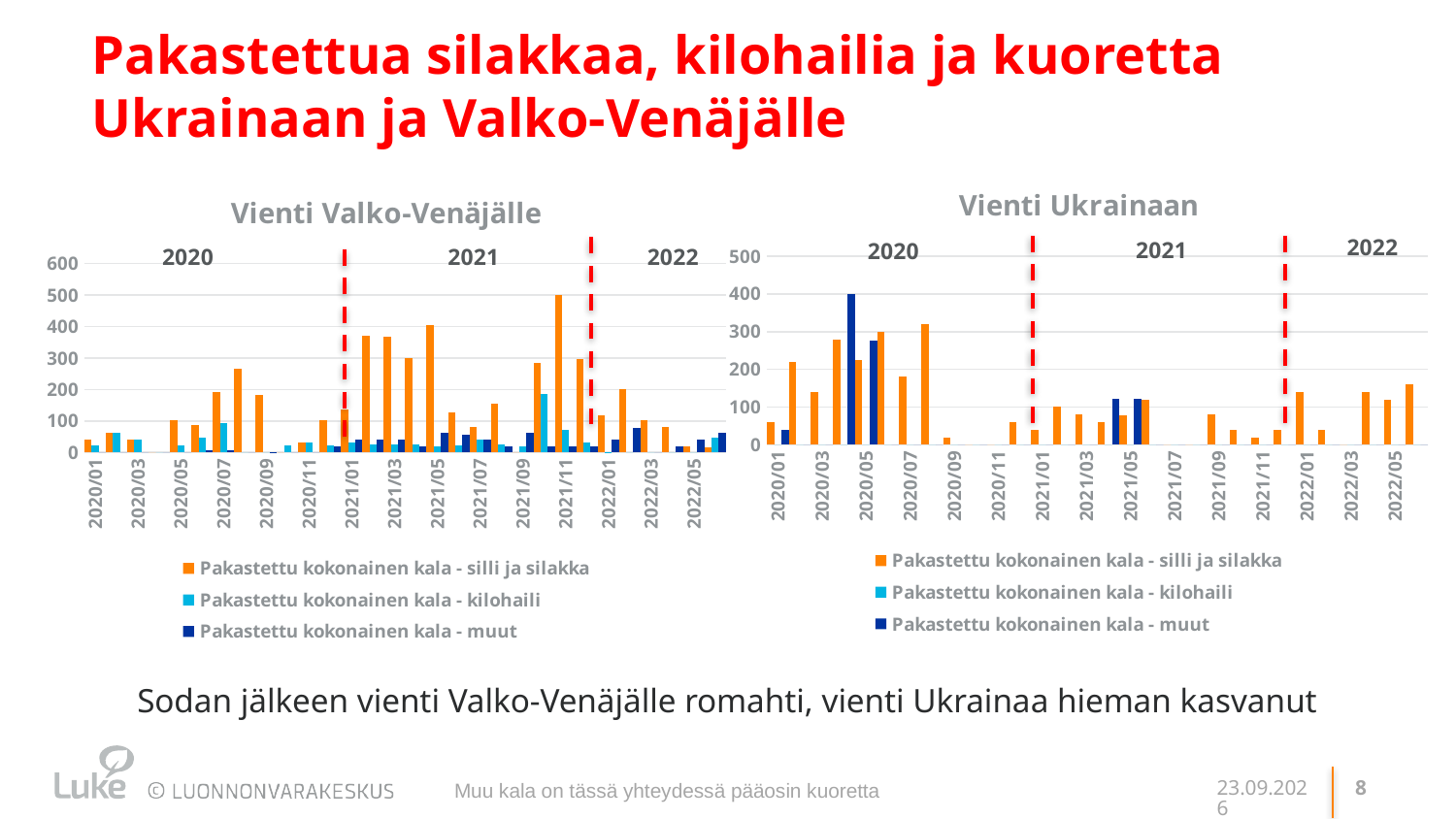
In the "Vienti Valko-Venäjälle" chart, which is larger: the "Pakastettu kokonainen kala - silli ja silakka" bar for 2021/11 or for 2020/01? 2021/11 In the "Vienti Valko-Venäjälle" chart, do the "Pakastettu kokonainen kala - silli ja silakka" values generally rise or fall from 2022/01 to 2022/05? fall Which series in the "Vienti Valko-Venäjälle" chart is shown in orange? Pakastettu kokonainen kala - silli ja silakka In the "Vienti Valko-Venäjälle" chart, which month has the highest "Pakastettu kokonainen kala - silli ja silakka" bar? 2021/11 How many series does the legend of the "Vienti Ukrainaan" chart list? 3 In the "Vienti Ukrainaan" chart, is the value of the "Pakastettu kokonainen kala - muut" bar for 2020/04 greater or less than 300? greater In the "Vienti Valko-Venäjälle" chart, is the value of the "Pakastettu kokonainen kala - silli ja silakka" bar for 2021/11 greater or less than 400? greater What is the highest value shown on the y axis of the "Vienti Ukrainaan" chart? 500 In the "Vienti Ukrainaan" chart, is the value of the "Pakastettu kokonainen kala - silli ja silakka" bar for 2022/05 greater or less than 100? greater What kind of chart is "Vienti Valko-Venäjälle"? bar chart In the "Vienti Ukrainaan" chart, which is larger: the "Pakastettu kokonainen kala - muut" bar for 2020/04 or the "Pakastettu kokonainen kala - silli ja silakka" bar for 2020/01? 2020/04 muut